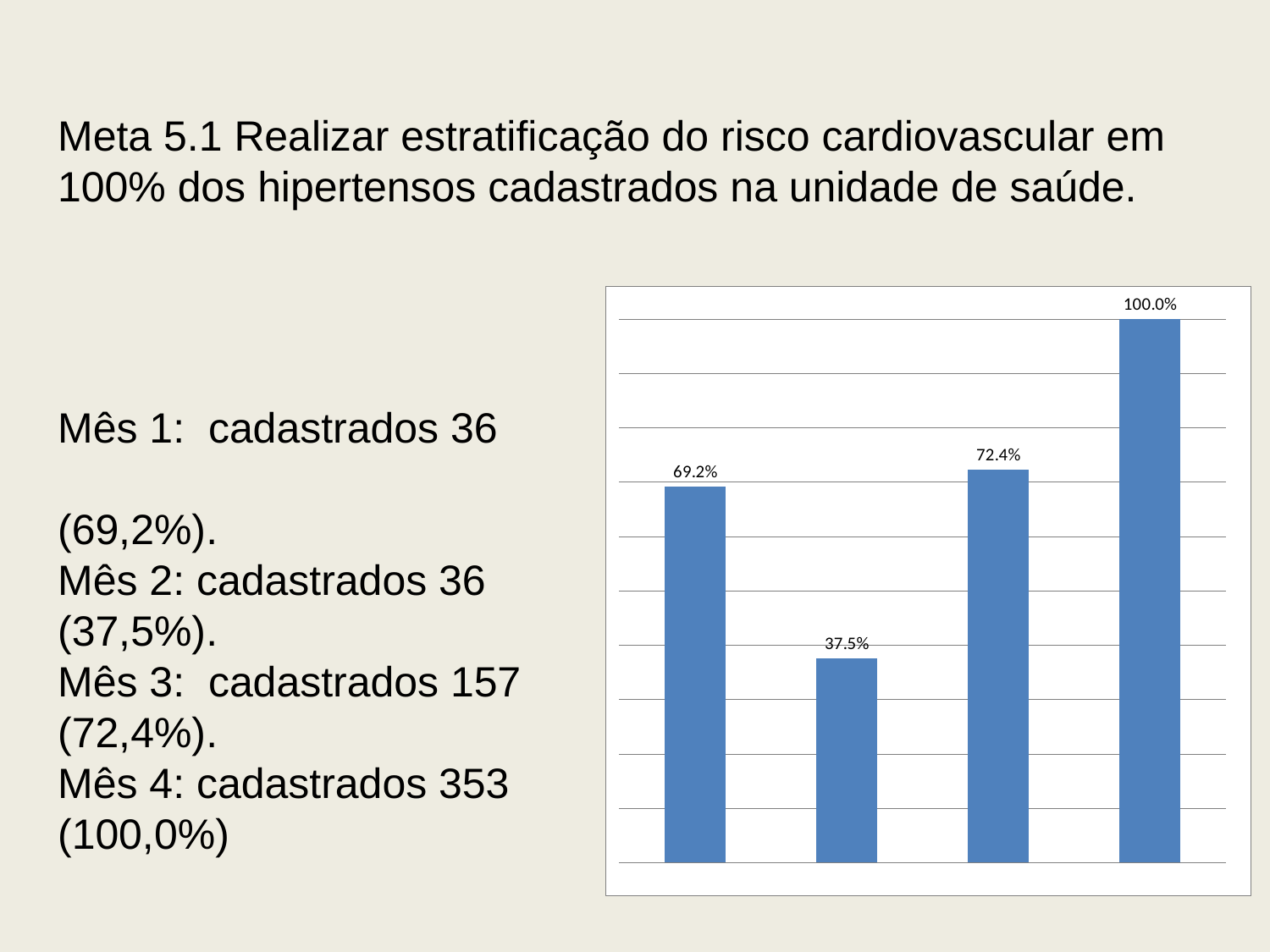
What is the difference between the highest and lowest bar values in the chart? 62.5% Do the bar values rise steadily from left to right across the chart? No, they fall from the first to the second bar and then rise What value is labelled on the fourth (rightmost) bar of the chart? 100.0% Which bar in the chart has the highest value? the fourth (rightmost) bar, 100.0% What value is labelled on the second bar of the chart? 37.5% What value is labelled on the third bar of the chart? 72.4% What value is labelled on the first (leftmost) bar of the chart? 69.2% What kind of chart is shown on the slide? bar chart Which bar in the chart has the lowest value? the second bar, 37.5% How many bars does the chart contain? 4 What is the difference between the third bar (72.4%) and the first bar (69.2%)? 3.2% Which is larger, the value of the first bar or the value of the third bar? the third bar (72.4%)